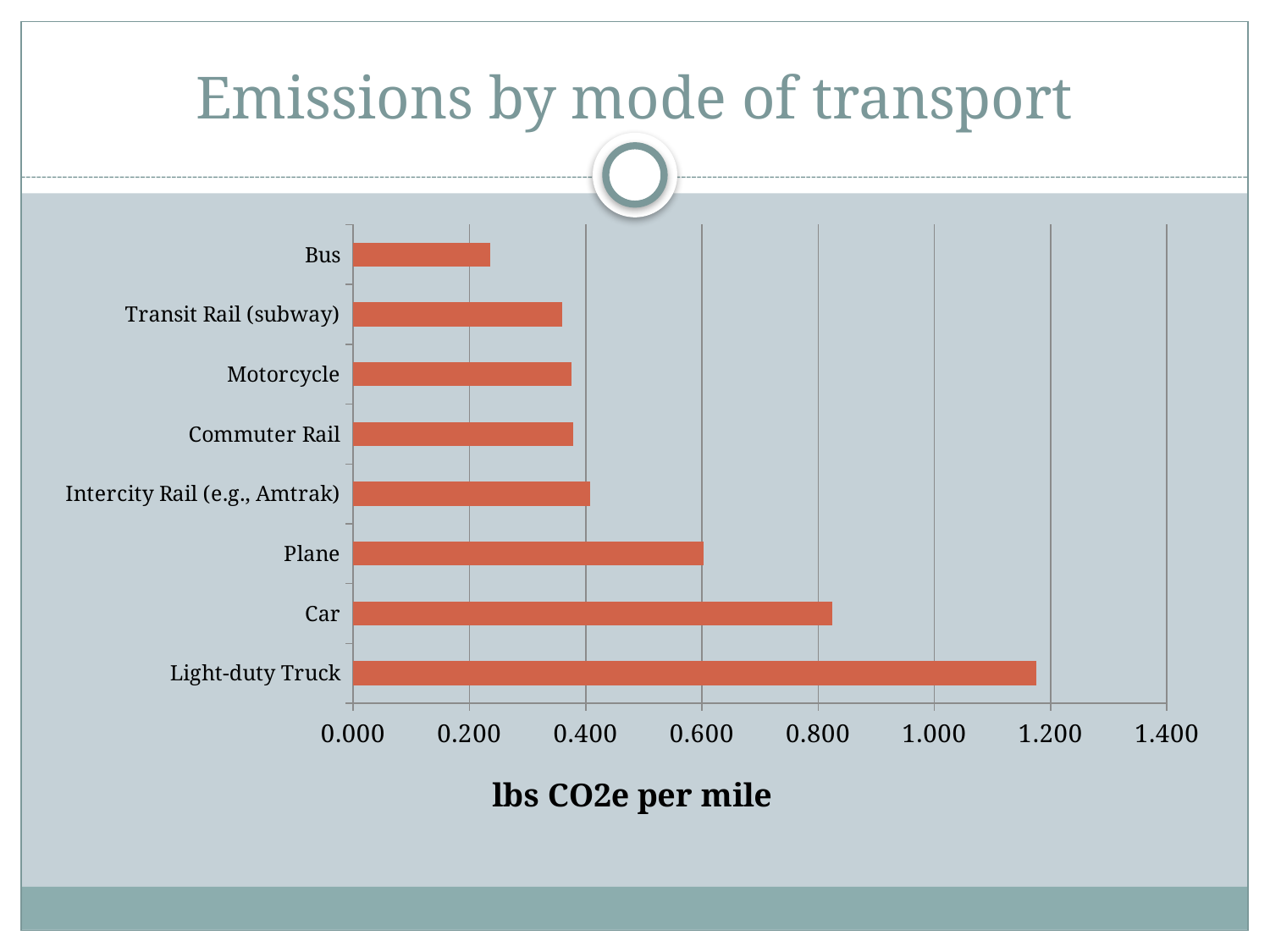
Which has higher emissions per mile, Bus or Transit Rail (subway)? Transit Rail (subway) Which mode of transport has the highest emissions per mile? Light-duty Truck What is the label on the horizontal axis of the chart? lbs CO2e per mile Which mode of transport has the lowest emissions per mile? Bus Is the value for Car greater or less than 0.600? greater Which has higher emissions per mile, Car or Plane? Car Is the value for Plane greater or less than 0.800? less Is the value for Intercity Rail (e.g., Amtrak) greater or less than 0.600? less How many modes of transport are plotted in the chart? 8 What type of chart is shown on the slide? bar chart